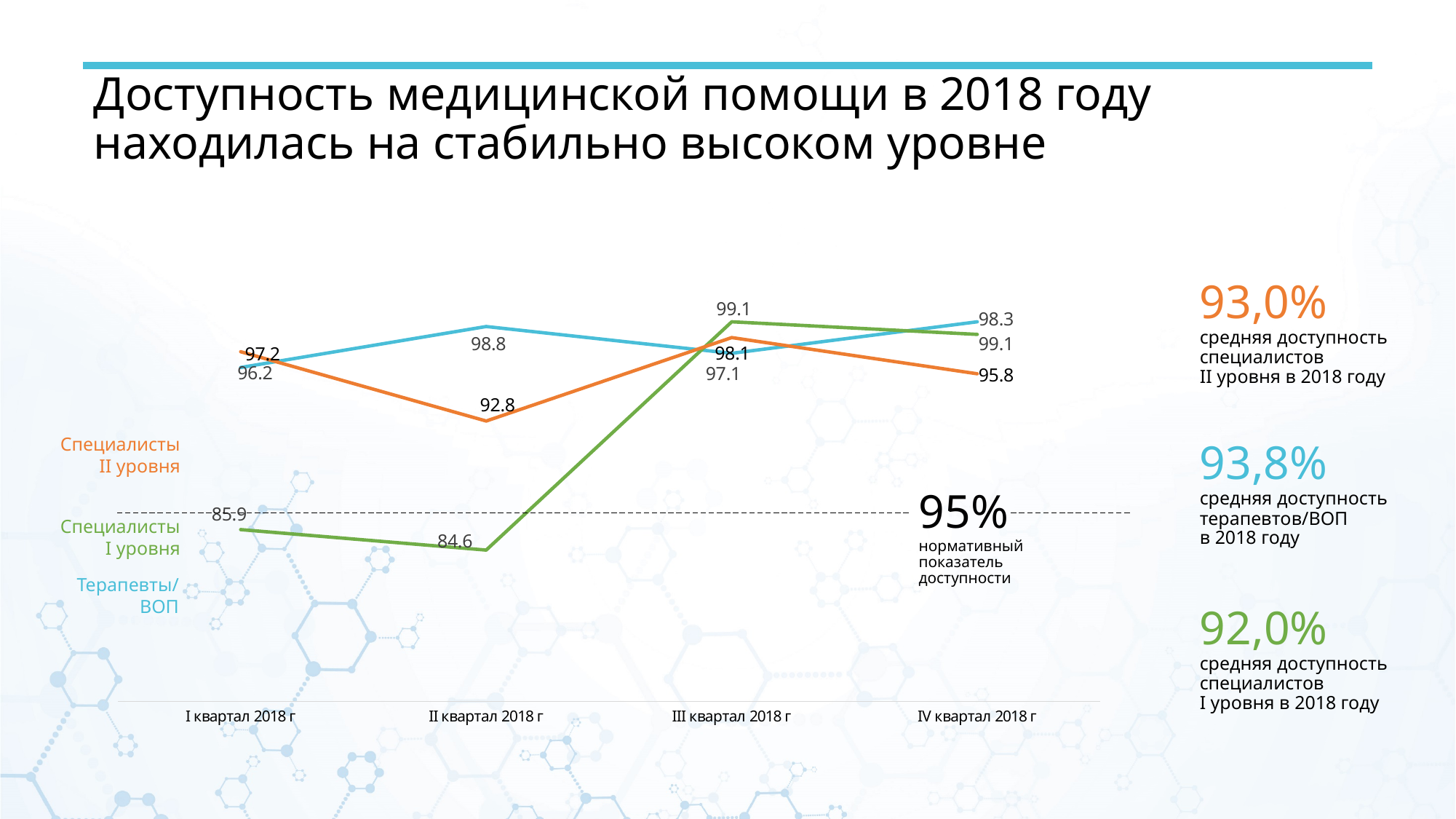
How many quarters are shown on the x axis? 4 What is the difference between the Специалисты I уровня values in III квартал 2018 г and II квартал 2018 г? 14.5 What is the value for Специалисты II уровня in II квартал 2018 г? 92.8 What is the value for Специалисты I уровня in I квартал 2018 г? 85.9 What is the difference between the Специалисты II уровня values in I квартал 2018 г and II квартал 2018 г? 4.4 In which quarter is the value for Специалисты II уровня highest? III квартал 2018 г In which quarter is the value for Специалисты I уровня lowest? II квартал 2018 г How many series are plotted on the chart? 3 In II квартал 2018 г, which is larger: Терапевты/ВОП or Специалисты II уровня? Терапевты/ВОП Does the value for Специалисты I уровня rise or fall from I квартал 2018 г to II квартал 2018 г? fall What kind of chart is shown on the slide? line chart What is the value for Терапевты/ВОП in II квартал 2018 г? 98.8